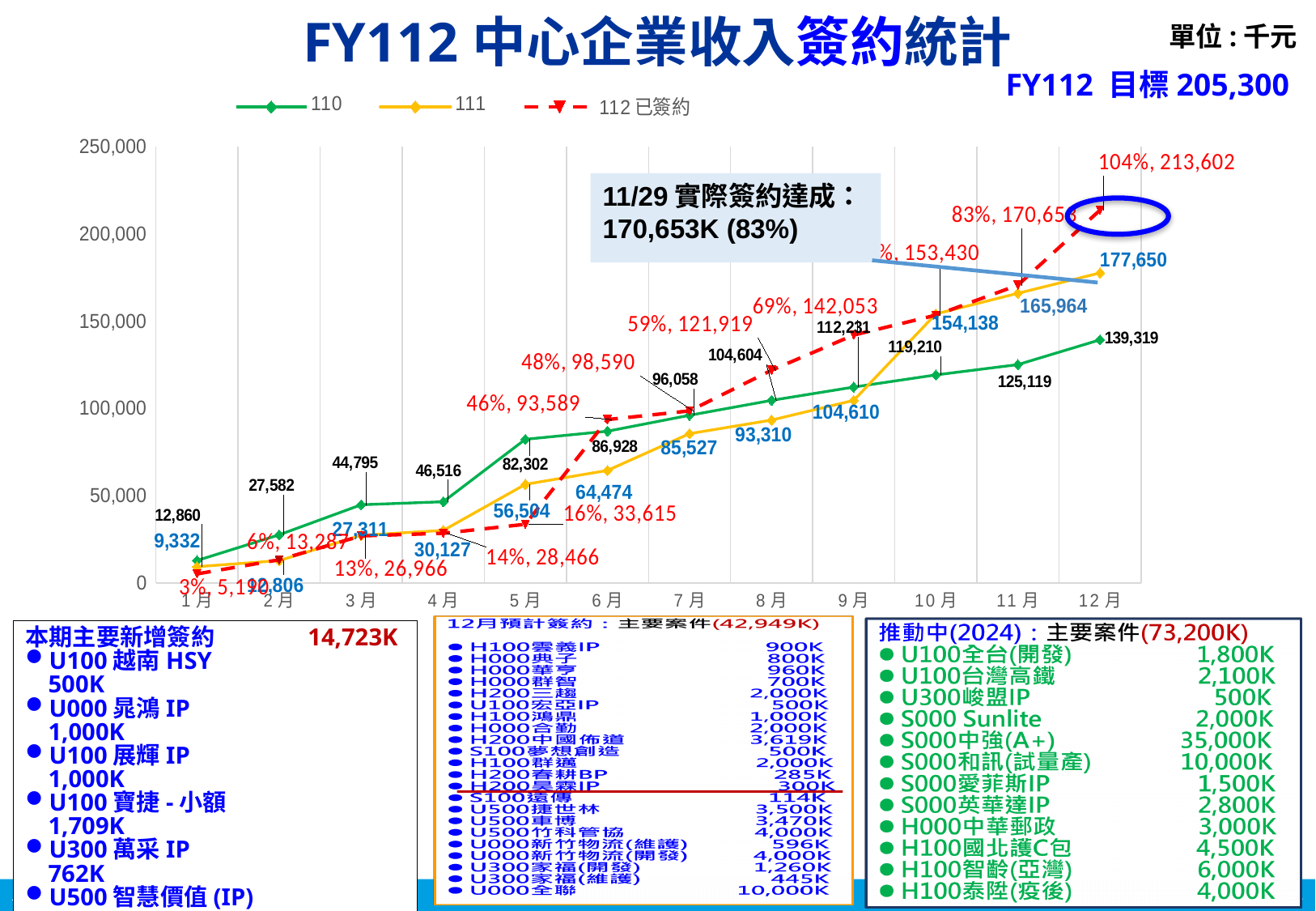
What is the value of series 111 in 12月? 177,650 How many series does the chart legend list? 3 In 9月, which series has the larger value, 110 or 111? 110 What is the value of series 110 in 12月? 139,319 What FY112 target value is stated on the slide? 205,300 In which month does series 110 reach its highest value? 12月 What kind of chart is shown on the slide? line chart What is the value of series 110 in 5月? 82,302 How many months are plotted along the x axis of the chart? 12 What is the value of series 112 已簽約 in 12月? 213,602 What is the difference between series 111 and series 110 in 12月? 38,331 What percentage is labelled for series 112 已簽約 in 8月? 59%